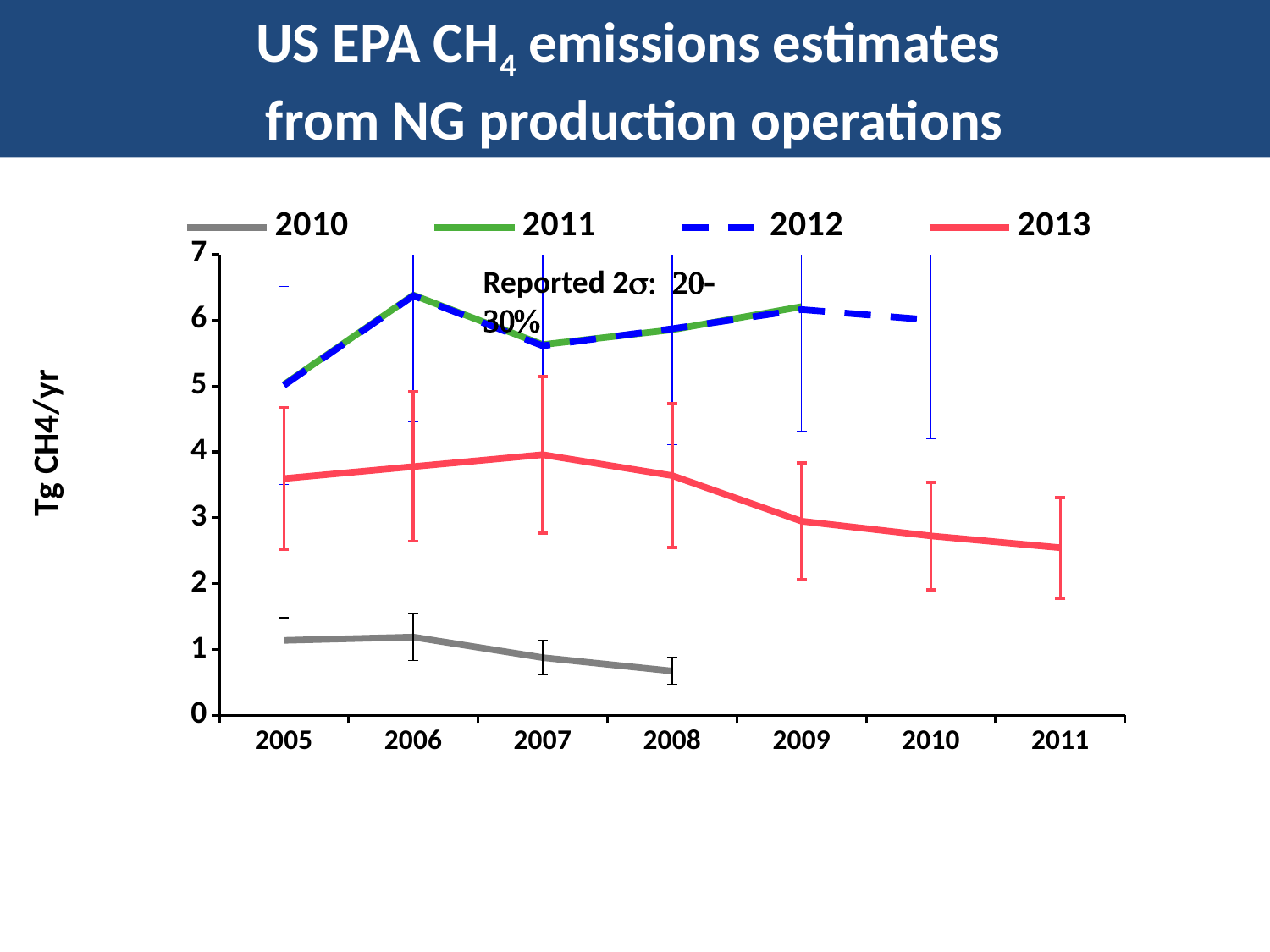
At 2007, which series has the larger value, 2013 or 2010? 2013 Is the value of the 2012 series at 2006 greater or less than 6? greater What kind of chart is shown on the slide? line chart Is the value of the 2010 series at 2008 greater or less than 1? less How many years are shown along the x axis? 7 What is the label on the y axis? Tg CH4/yr Is the value of the 2013 series at 2005 greater or less than 3? greater Which series has the lowest values on the chart? 2010 How many series does the legend list? 4 Does the 2013 series rise or fall from 2007 to 2011? fall Which series in the legend is drawn with a dashed line? 2012